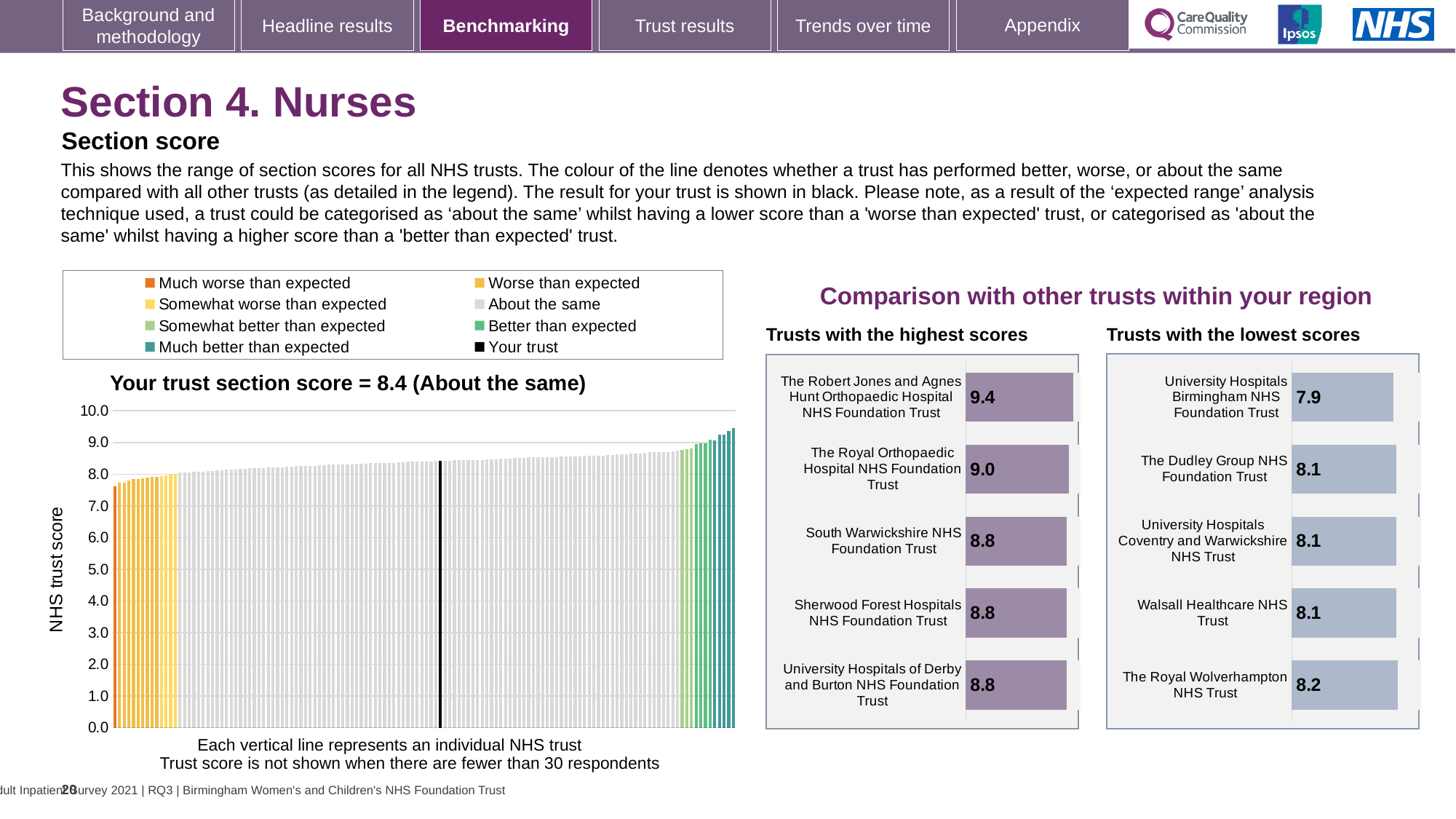
In the 'Trusts with the lowest scores' chart, what is the score for The Royal Wolverhampton NHS Trust? 8.2 How many trusts are shown in the 'Trusts with the lowest scores' chart? 5 In the 'Trusts with the lowest scores' chart, which trust has the lowest score? University Hospitals Birmingham NHS Foundation Trust In the 'Your trust section score' chart, do the trust scores rise or fall from left to right along the x axis? rise In the 'Trusts with the highest scores' chart, what is the difference between the scores of The Robert Jones and Agnes Hunt Orthopaedic Hospital NHS Foundation Trust and The Royal Orthopaedic Hospital NHS Foundation Trust? 0.4 How many entries does the legend above the 'Your trust section score' chart list? 8 In the 'Your trust section score' chart, which category does your trust fall into? About the same What kind of chart is the 'Your trust section score' chart? bar chart In the 'Your trust section score' chart, what is the section score for your trust? 8.4 In the 'Your trust section score' chart, is the score of the rightmost (highest) trust greater or less than 9.0? greater What is the y-axis label of the 'Your trust section score' chart? NHS trust score In the 'Trusts with the highest scores' chart, what is the score for The Robert Jones and Agnes Hunt Orthopaedic Hospital NHS Foundation Trust? 9.4